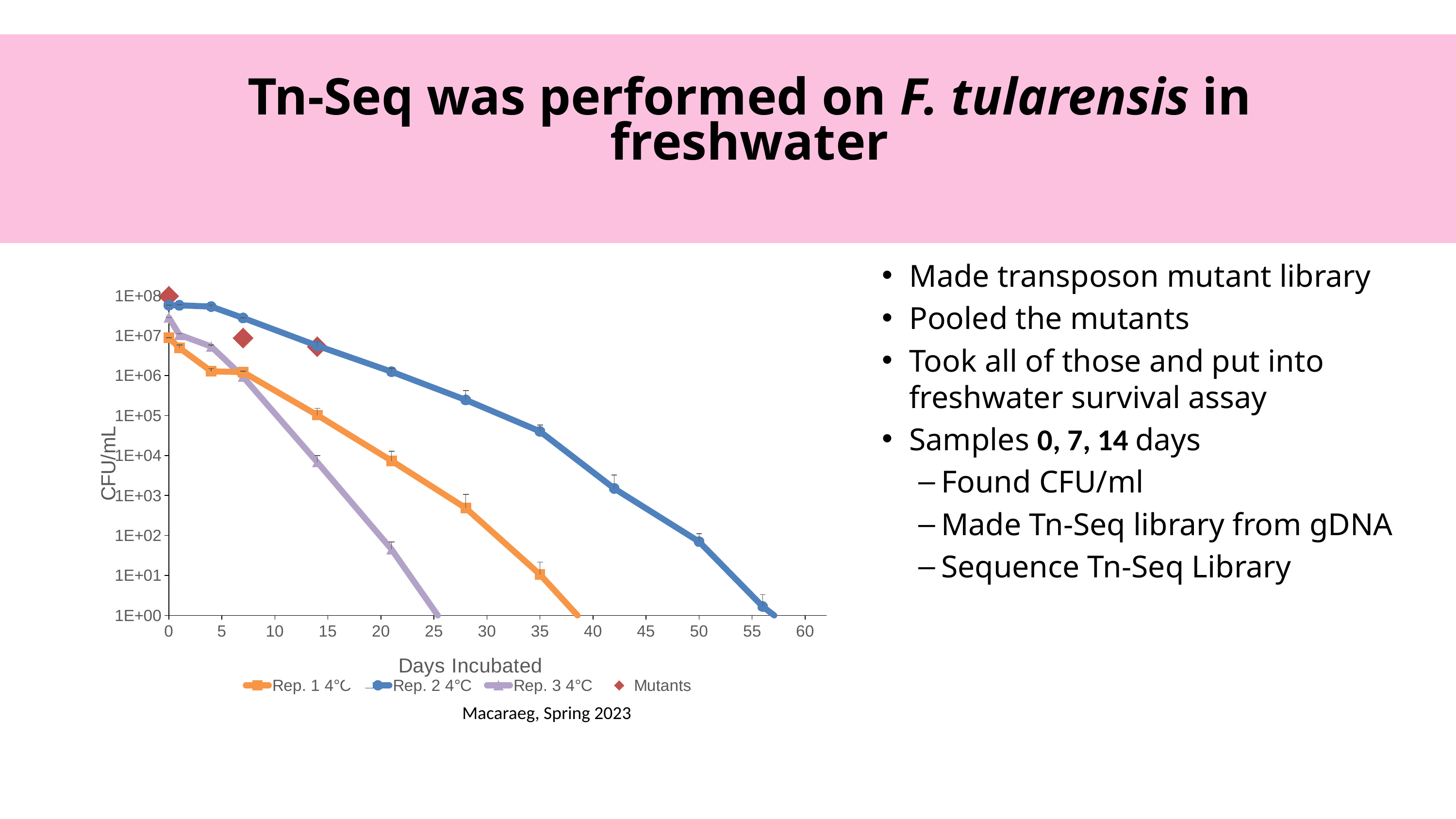
How many Mutants points are plotted on the chart? 3 What kind of chart is shown on the slide? line chart Do the CFU/mL values for Rep. 2 4°C rise or fall as days incubated increase? fall How many series does the chart legend list? 4 Which replicate series reaches 1E+00 CFU/mL at the latest day? Rep. 2 4°C What is the title of the y axis of the chart? CFU/mL At day 14, which series has the higher CFU/mL, Rep. 2 4°C or Rep. 3 4°C? Rep. 2 4°C What is the title of the x axis of the chart? Days Incubated Is the value for Rep. 2 4°C at day 35 greater or less than 1E+04? greater Is the value for Rep. 1 4°C at day 28 greater or less than 1E+03? less Is the value for Rep. 2 4°C at day 0 greater or less than 1E+07? greater